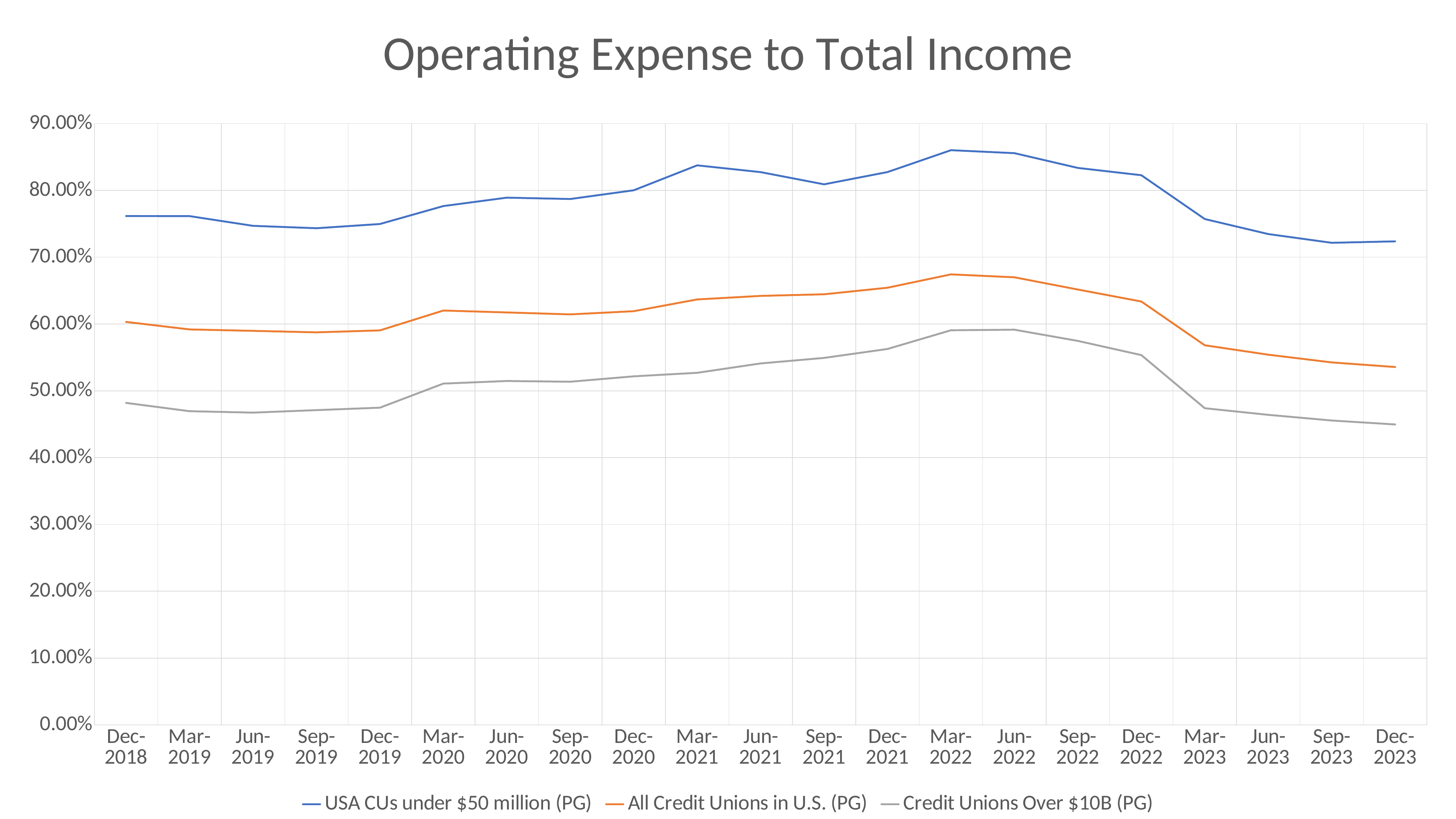
What kind of chart is shown on the slide? line chart Is the value for USA CUs under $50 million (PG) at Mar-2022 greater or less than 80.00%? greater How many time points are shown on the x axis? 21 At which time point is the value for Credit Unions Over $10B (PG) lowest? Dec-2023 For Credit Unions Over $10B (PG), is the value larger at Dec-2018 or at Dec-2023? Dec-2018 Is the value for All Credit Unions in U.S. (PG) at Mar-2022 greater or less than 60.00%? greater Which series is drawn in orange? All Credit Unions in U.S. (PG) Which series has the highest value at Dec-2023? USA CUs under $50 million (PG) Is the value for Credit Unions Over $10B (PG) at Dec-2023 greater or less than 50.00%? less Do the values for USA CUs under $50 million (PG) rise or fall from Mar-2022 to Dec-2023? fall How many series does the legend list? 3 What is the title of the chart? Operating Expense to Total Income